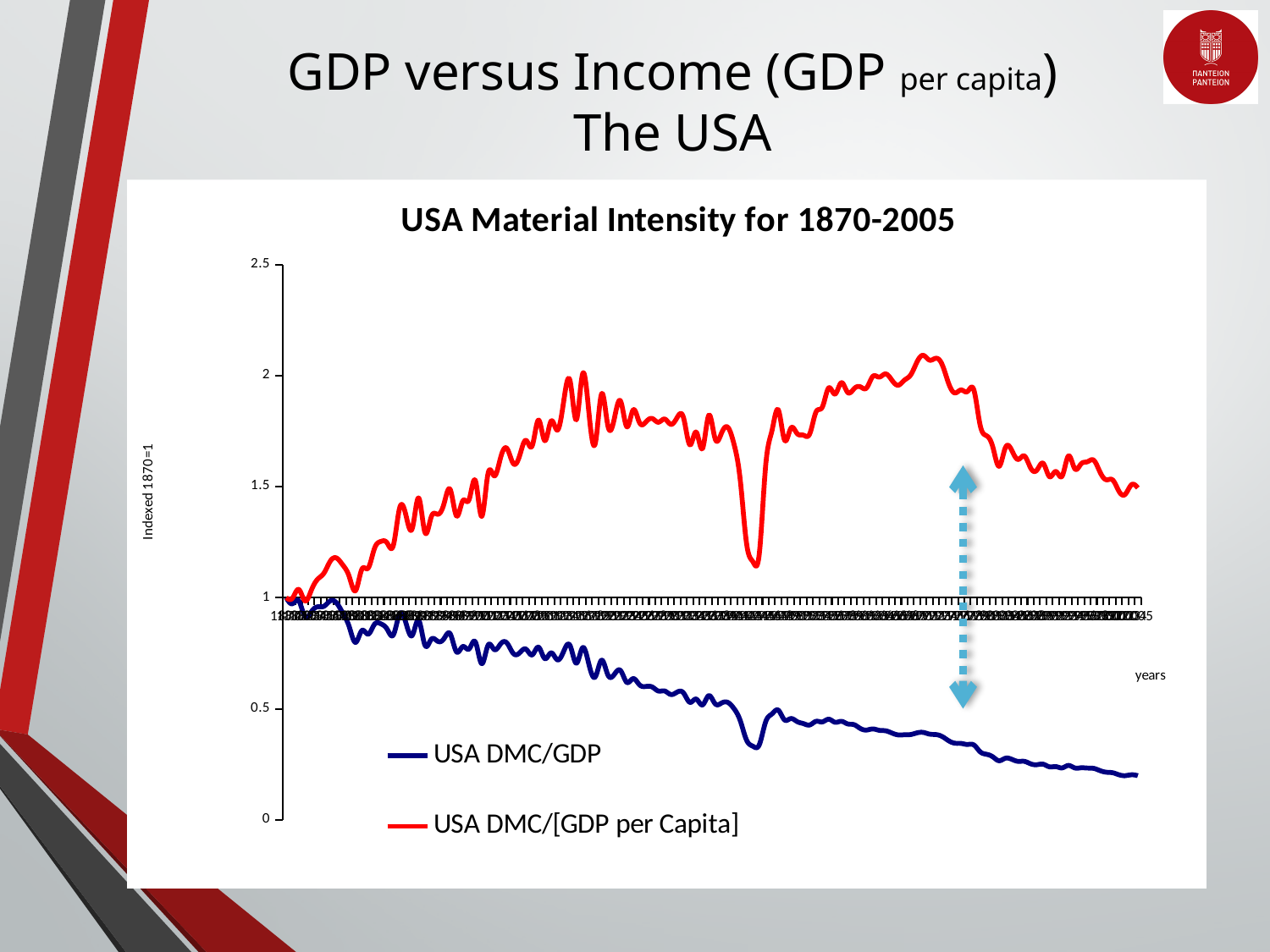
What is the highest value shown on the vertical axis? 2.5 Is the value of USA DMC/[GDP per Capita] at the end of the period greater or less than 1? greater Is the value of USA DMC/GDP at the end of the period greater or less than 0.5? less How many series does the legend list? 2 What is the title of the chart? USA Material Intensity for 1870-2005 Does the USA DMC/GDP series rise or fall over the period shown? fall Which series is higher at the end of the period, USA DMC/GDP or USA DMC/[GDP per Capita]? USA DMC/[GDP per Capita] Is the peak value of USA DMC/[GDP per Capita] greater or less than 2? greater What kind of chart is shown on the slide? line chart Does the USA DMC/[GDP per Capita] series generally rise or fall from 1870 to around 1970? rise Which series is drawn in red? USA DMC/[GDP per Capita]